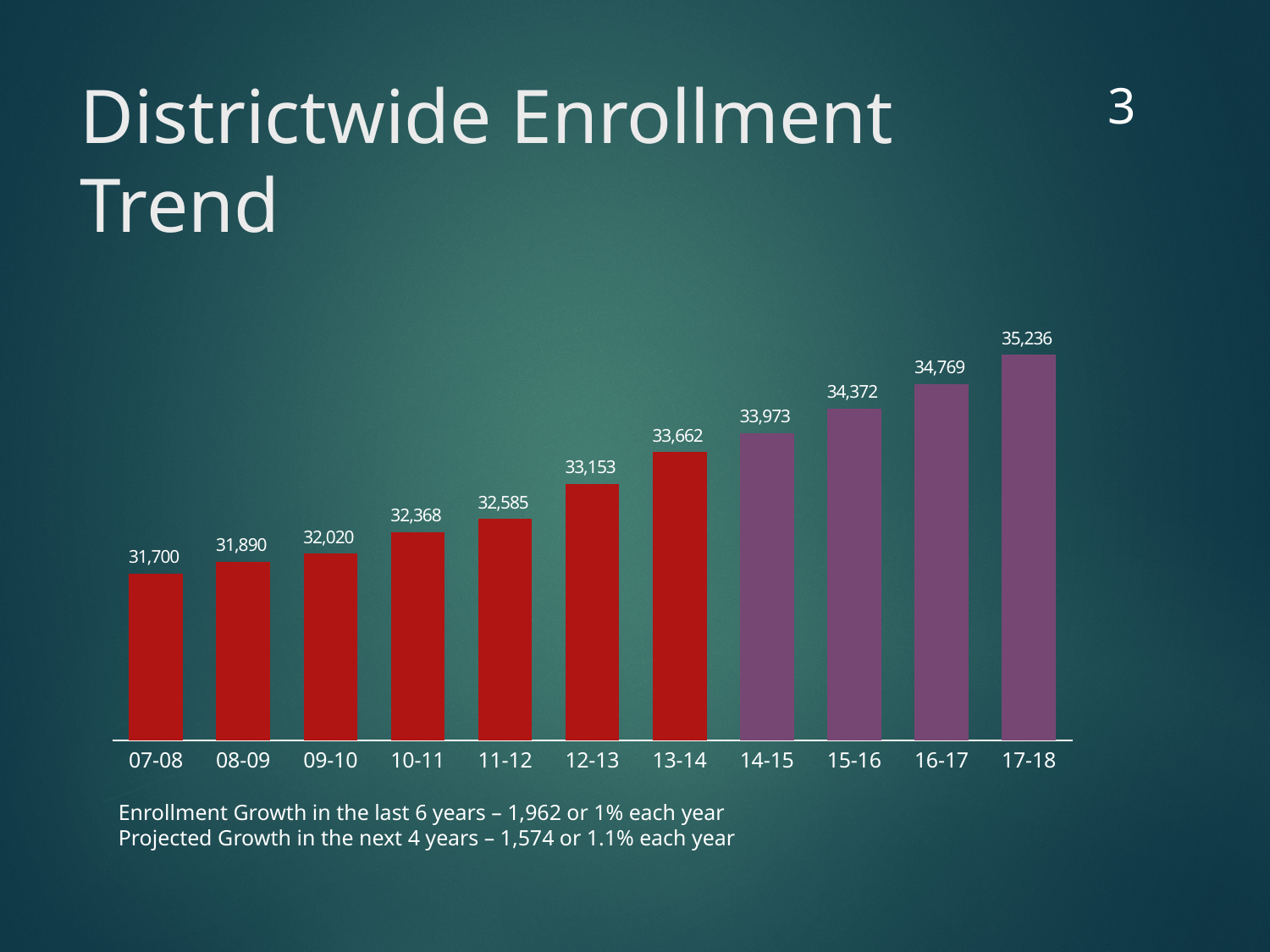
Which is larger, the enrollment for 14-15 or for 11-12? 14-15 What kind of chart is shown on the slide? bar chart What is the enrollment value for 07-08? 31,700 Which year has the highest enrollment? 17-18 What is the enrollment value for 13-14? 33,662 What is the enrollment value for 17-18? 35,236 What is the difference in enrollment between 13-14 and 12-13? 509 What is the difference in enrollment between 17-18 and 07-08? 3,536 How many years are shown on the x axis? 11 Do the enrollment values rise or fall from 07-08 to 17-18? rise What is the enrollment value for 10-11? 32,368 Which year has the lowest enrollment? 07-08